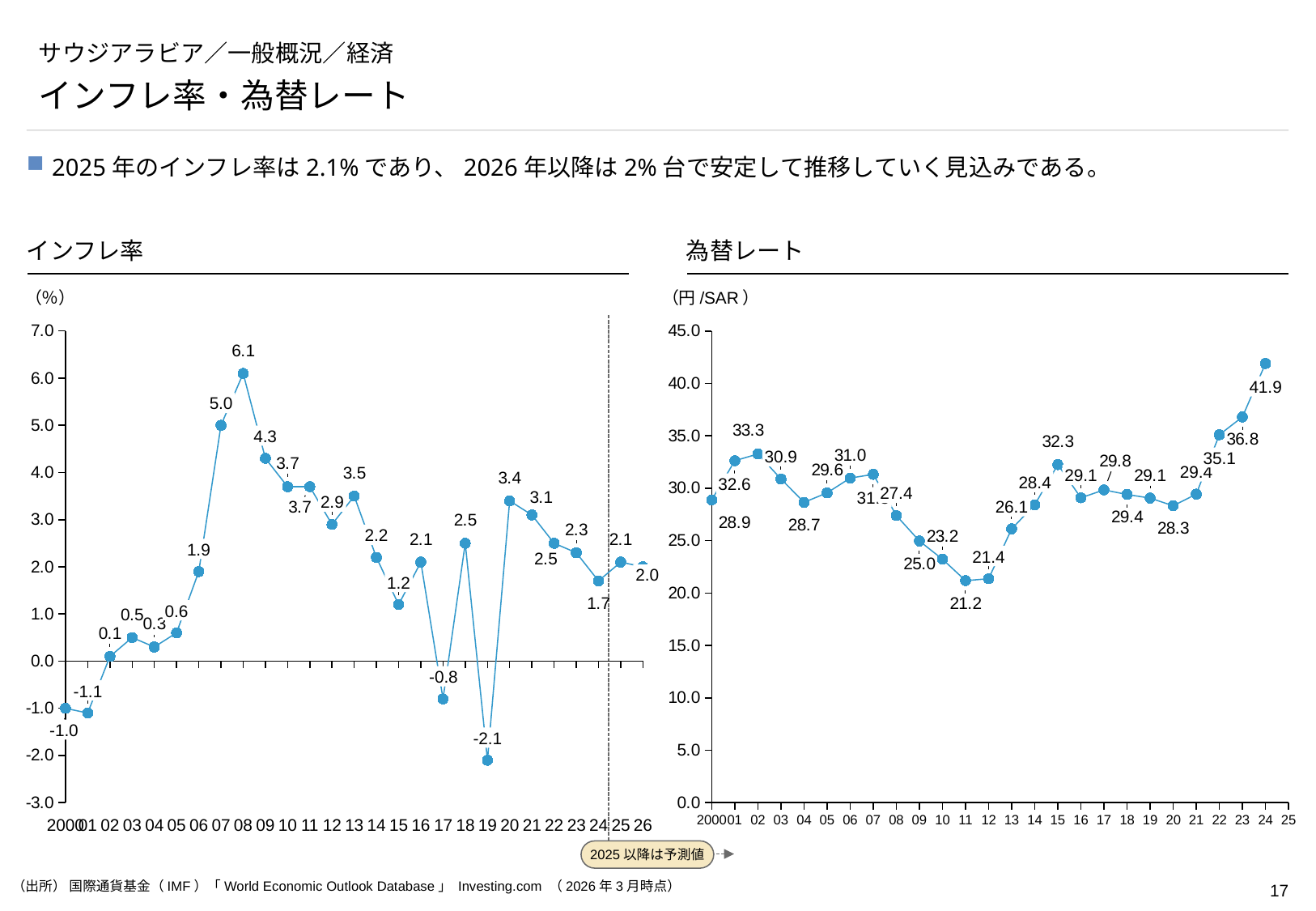
On the インフレ率 chart, what is the difference between the 2008 value and the 2007 value? 1.1 On the 為替レート chart, what unit is shown on the vertical axis? 円/SAR On the インフレ率 chart, which year has the highest inflation rate? 2008 What kind of chart is the 為替レート chart? line chart On the インフレ率 chart, what is the inflation rate for 2008? 6.1 On the 為替レート chart, what is the difference between the 2024 value and the 2023 value? 5.1 On the インフレ率 chart, what is the value for 2019? -2.1 On the インフレ率 chart, which year has the lowest value? 2019 On the 為替レート chart, which year has the lowest value? 2011 On the インフレ率 chart, which is larger, the value for 2020 or the value for 2021? 2020 On the 為替レート chart, is the value for 2024 greater or less than 40.0? greater On the 為替レート chart, what is the value for 2024? 41.9